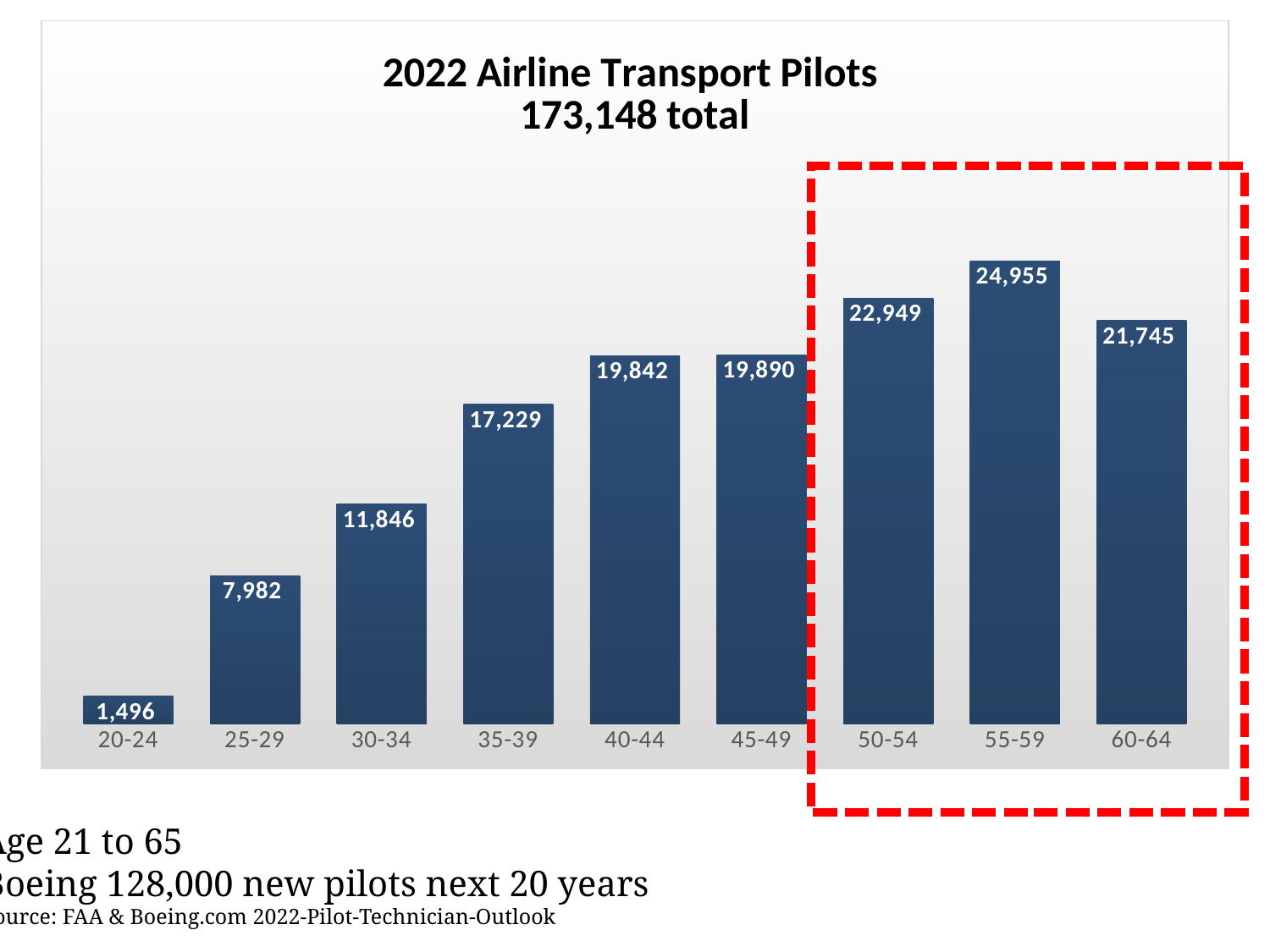
Which age group has the lowest number of pilots? 20-24 What is the difference between the values for 55-59 and 50-54? 2,006 Which is larger, the value for 50-54 or the value for 60-64? 50-54 What total is stated in the chart title? 173,148 How many age groups are shown on the chart? 9 What is the value for the 60-64 age group? 21,745 What is the value for the 35-39 age group? 17,229 What kind of chart is shown on the slide? bar chart What is the value for the 20-24 age group? 1,496 What is the difference between the values for 30-34 and 25-29? 3,864 Which age group has the highest number of pilots? 55-59 Do the values rise or fall from the 20-24 group to the 55-59 group? rise